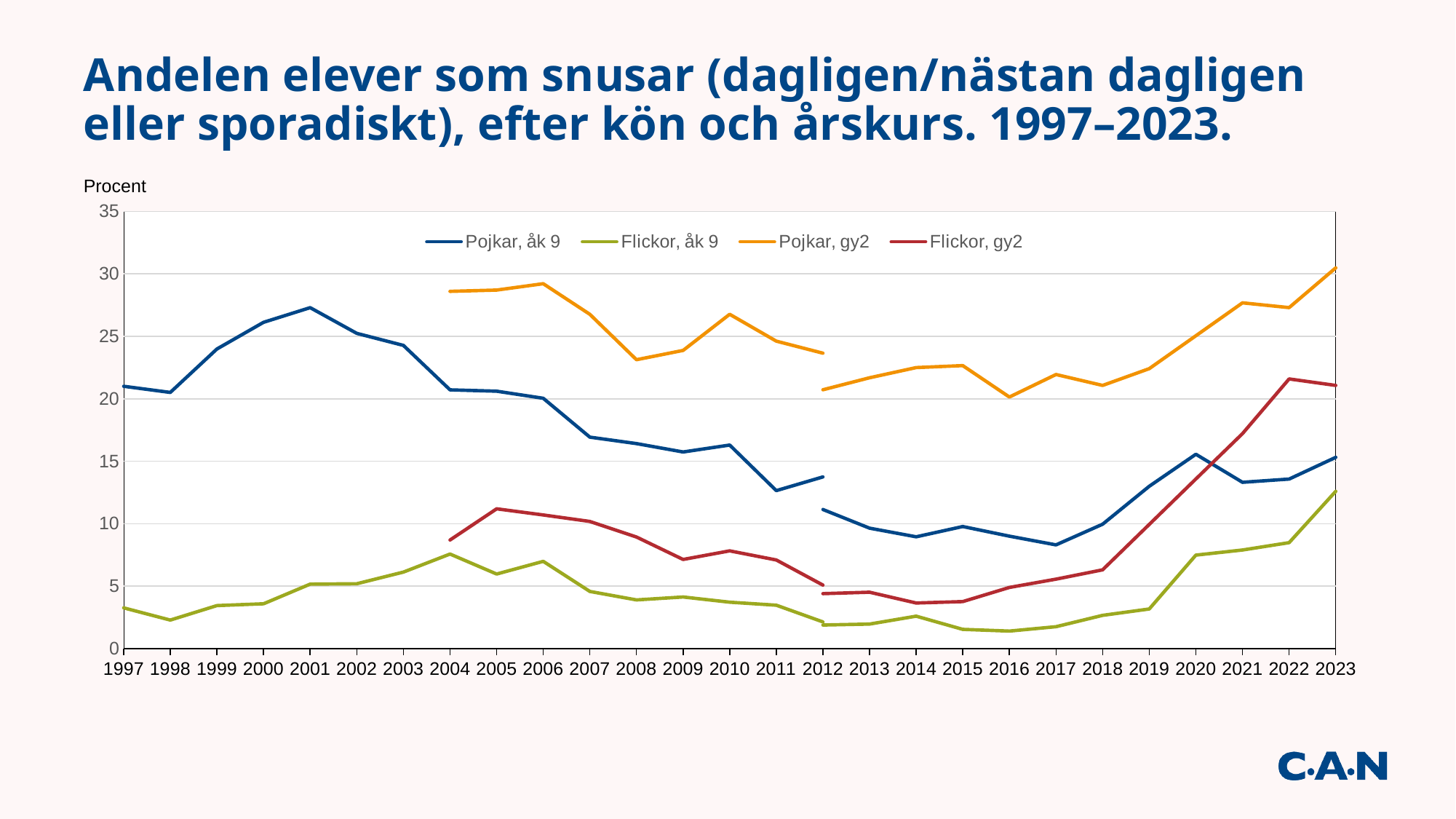
In 2023, which is larger: Flickor, gy2 or Pojkar, åk 9? Flickor, gy2 Which series has the lowest value in 2023? Flickor, åk 9 Does the Flickor, gy2 line rise or fall between 2017 and 2022? rise What kind of chart is shown on the slide? line chart Is the value for Flickor, åk 9 in 2016 greater or less than 5? less Is the value for Pojkar, åk 9 in 2001 greater or less than 25? greater Is the value for Pojkar, gy2 in 2023 greater or less than 25? greater Which series has the highest value in 2023? Pojkar, gy2 How many series does the legend list? 4 How many years are shown along the x axis? 27 What is the label on the y axis? Procent